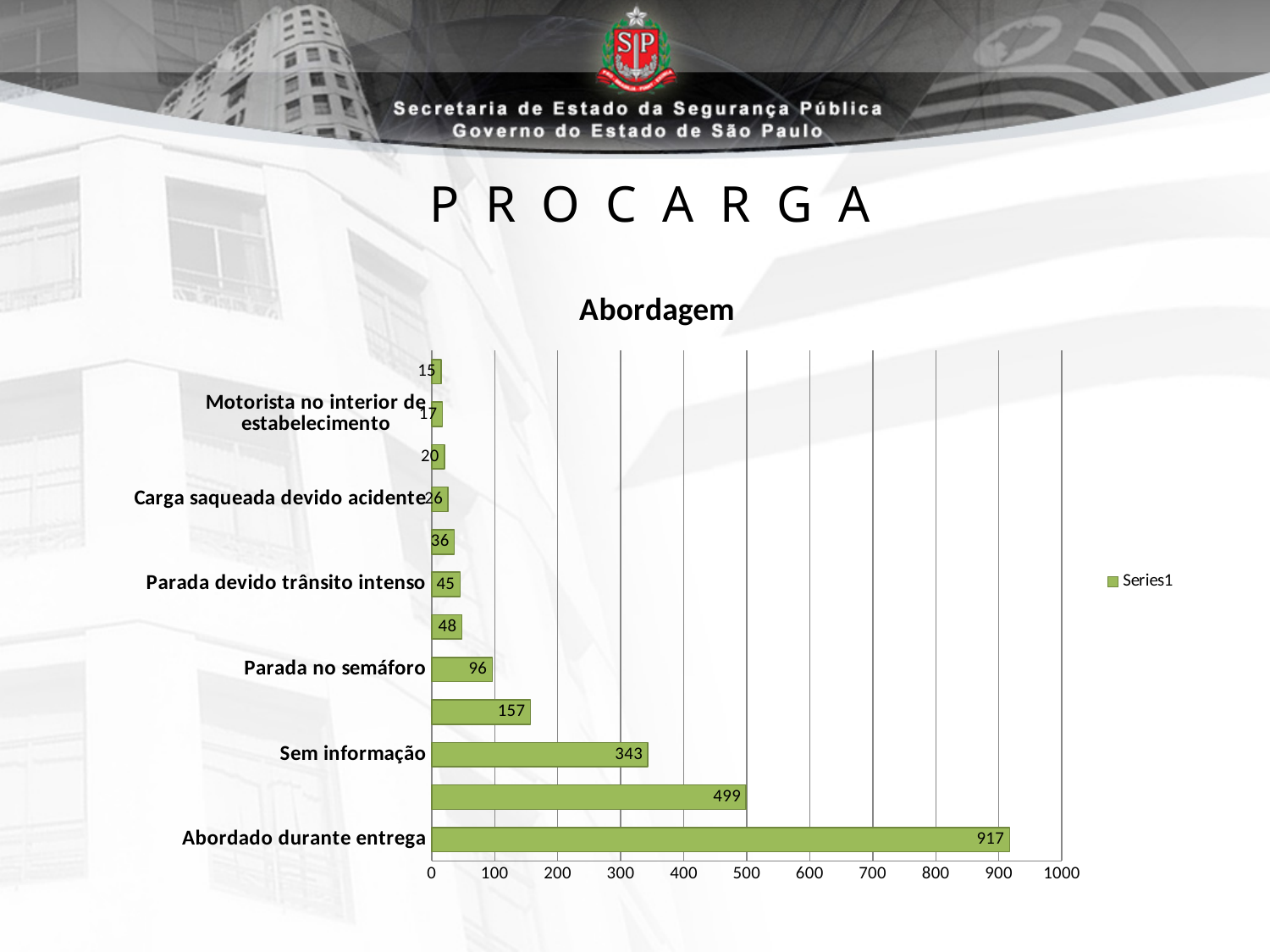
Which is larger, the value for "Parada no semáforo" or "Parada devido trânsito intenso"? Parada no semáforo Which category has the highest value? Abordado durante entrega What is the value for "Parada no semáforo"? 96 What is the difference between the values for "Abordado durante entrega" and "Sem informação"? 574 What is the smallest value shown on the chart? 15 What kind of chart is shown? Bar chart What is the value for "Parada devido trânsito intenso"? 45 What is the value for "Abordado durante entrega"? 917 What is the value for "Carga saqueada devido acidente"? 26 How many bars are plotted on the chart? 12 What is the value for "Sem informação"? 343 What is the title of the chart? Abordagem